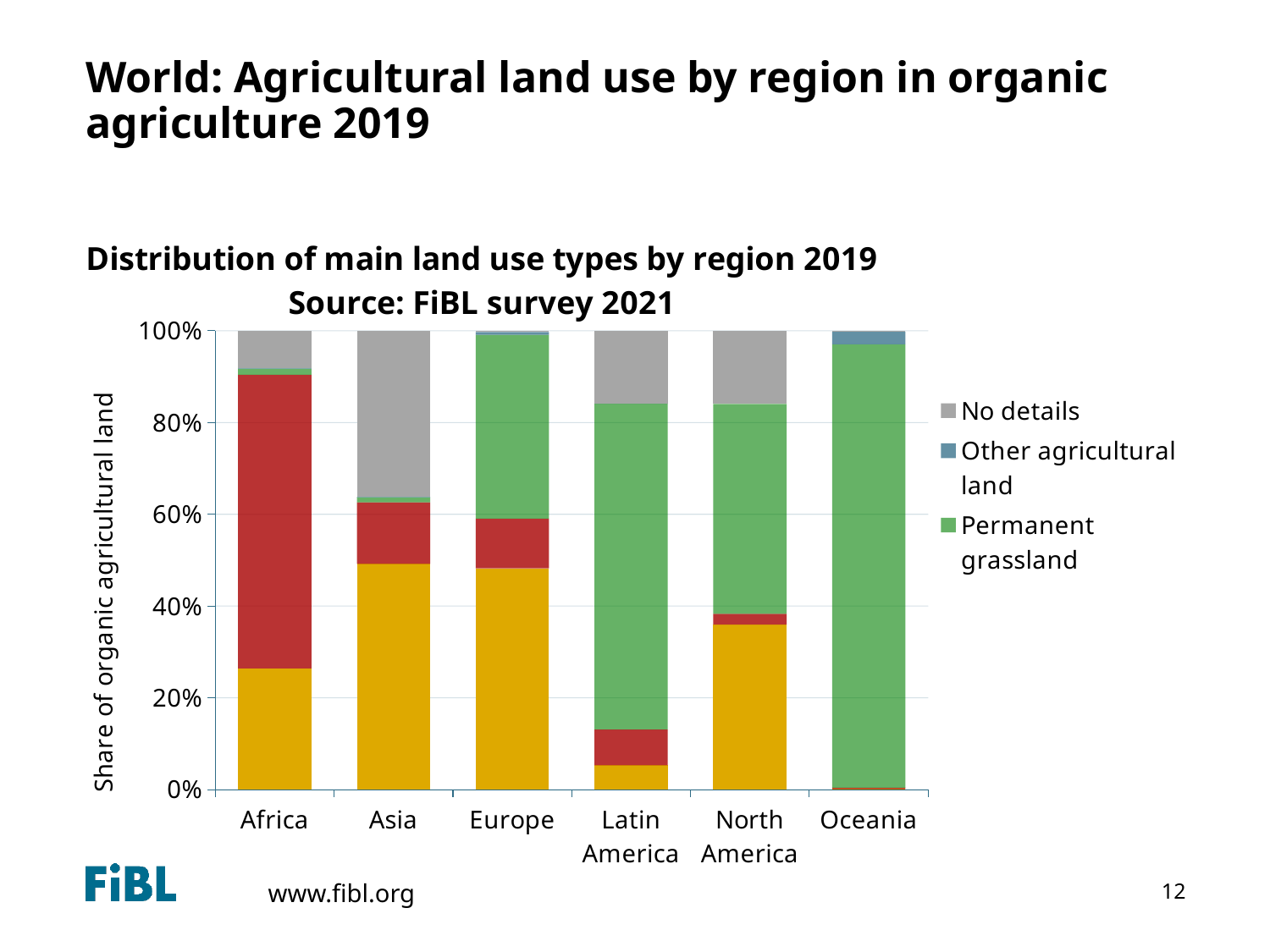
What kind of chart is shown on the slide? Stacked bar chart How many series does the visible legend list? 3 Which region has the largest share of permanent grassland? Oceania How many regions are shown on the x axis of the chart? 6 Which region has a larger permanent grassland share, Europe or Asia? Europe What is the total height of the Africa bar? 100% Which region has a larger 'No details' share, Asia or Europe? Asia Is the 'No details' share for Asia greater or less than 20%? greater What is the label on the y axis of the chart? Share of organic agricultural land Is the permanent grassland share for North America greater or less than 40%? greater Is the permanent grassland share for Oceania greater or less than 80%? greater